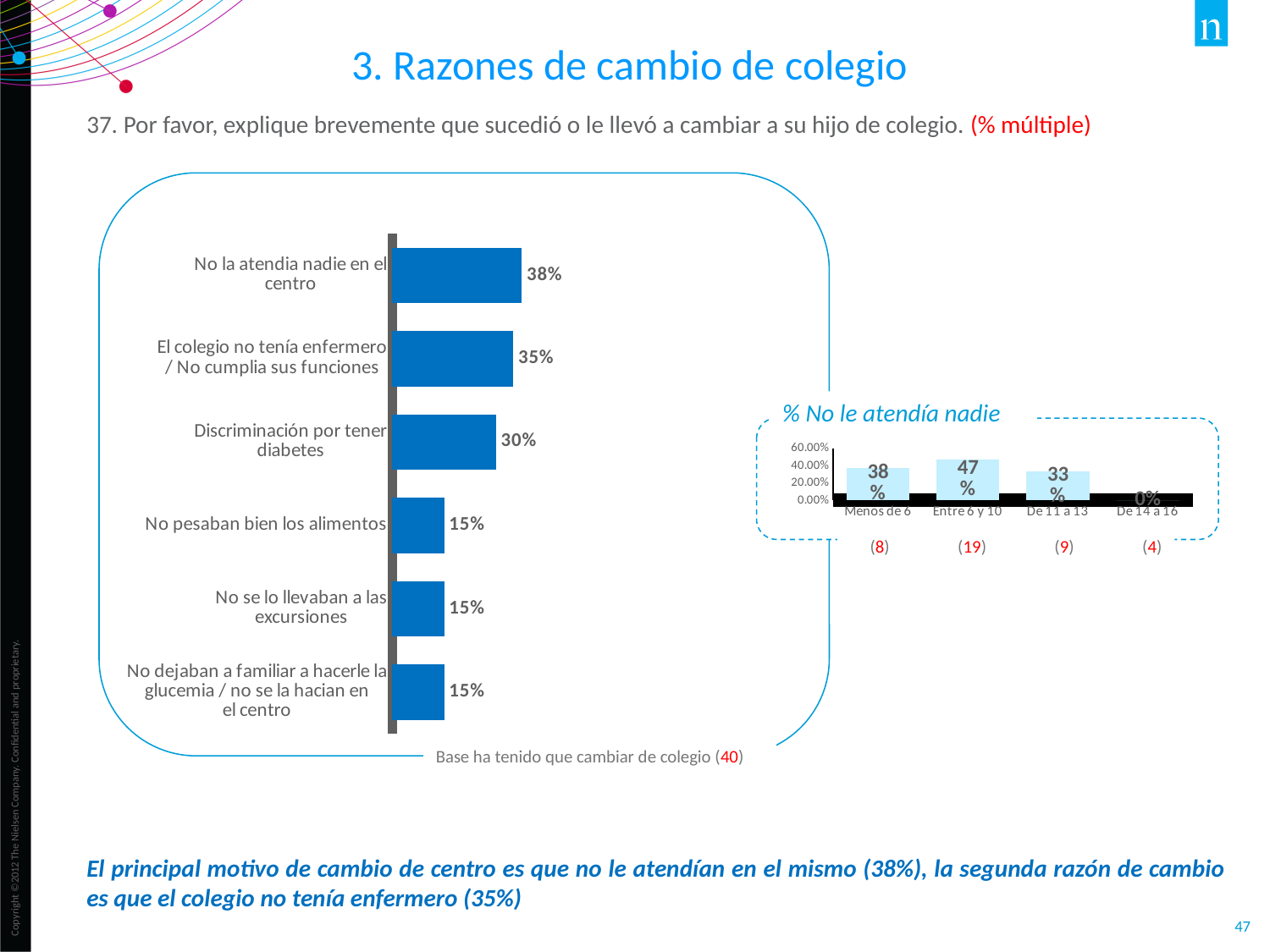
In the large bar chart on the left, what is the value for 'Discriminación por tener diabetes'? 30% In the large bar chart on the left, which category has the highest value? No la atendia nadie en el centro In the chart titled '% No le atendía nadie', which age group has the lowest value? De 14 a 16 In the large bar chart on the left, what is the value for 'No la atendia nadie en el centro'? 38% How many categories are shown in the large bar chart on the left? 6 In the large bar chart on the left, what is the difference between 'No la atendia nadie en el centro' and 'El colegio no tenía enfermero / No cumplia sus funciones'? 3% How many age groups are shown in the chart titled '% No le atendía nadie'? 4 In the large bar chart on the left, which is larger: 'Discriminación por tener diabetes' or 'No pesaban bien los alimentos'? Discriminación por tener diabetes In the chart titled '% No le atendía nadie', what is the value for 'Entre 6 y 10'? 47% What kind of chart is the large chart on the left? Bar chart What is the base (number of respondents) stated below the large bar chart on the left? 40 In the chart titled '% No le atendía nadie', what is the difference between 'Entre 6 y 10' and 'De 11 a 13'? 14%